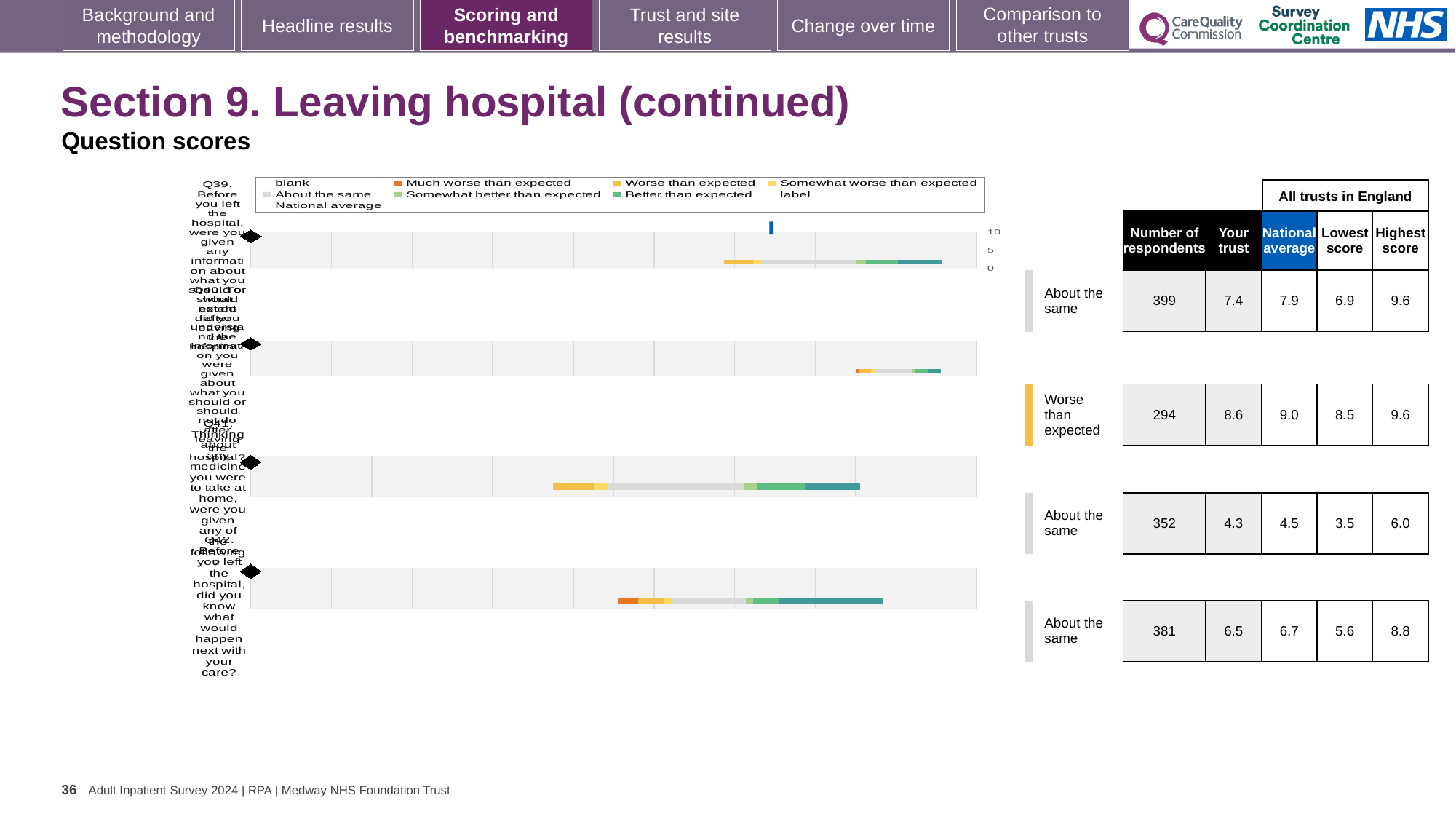
In the table beside the chart, what is the lowest score in the third row? 3.5 What benchmark label is shown next to the second row of the chart? Worse than expected How many entries does the chart's legend list? 9 In the first row (Q39) of the table, what is the difference between the highest score and the lowest score? 2.7 In the first row (Q39) of the table, which is larger: the 'Your trust' score or the national average? national average In the table beside the chart, what is the national average in the first row (Q39)? 7.9 How many question rows (bars) are plotted in the chart? 4 In the table beside the chart, what is the 'Your trust' score in the first row (Q39)? 7.4 What colour does the legend use for 'Much worse than expected'? orange Which row of the table has the highest 'Your trust' score? the second row (Worse than expected), 8.6 In the table beside the chart, what is the number of respondents in the last row (Q42)? 381 What kind of chart is shown on the slide? bar chart